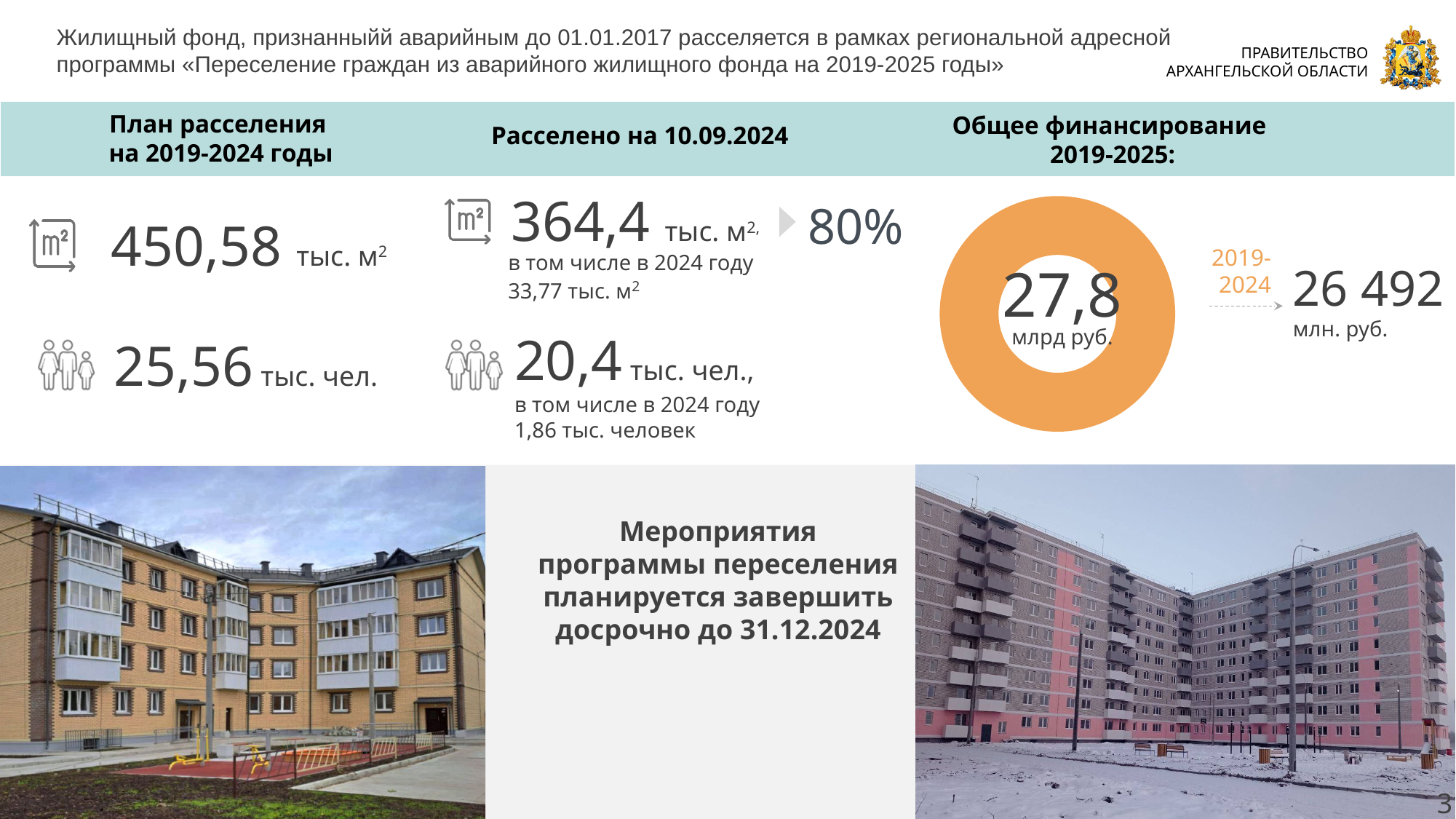
What colour is the ring chart under "Общее финансирование 2019-2025"? Orange What kind of chart is the orange ring under "Общее финансирование 2019-2025"? Donut (pie) chart What value is shown in the centre of the orange ring chart under "Общее финансирование 2019-2025"? 27,8 млрд руб. What value is shown to the right of the ring chart for 2019-2024? 26 492 млн. руб. In what units is the value in the centre of the ring chart expressed? млрд руб. Is the value in the centre of the ring chart (in млрд руб.) greater or less than 20? greater What is the title of the section containing the orange ring chart? Общее финансирование 2019-2025: How many segments does the orange ring chart contain? 1